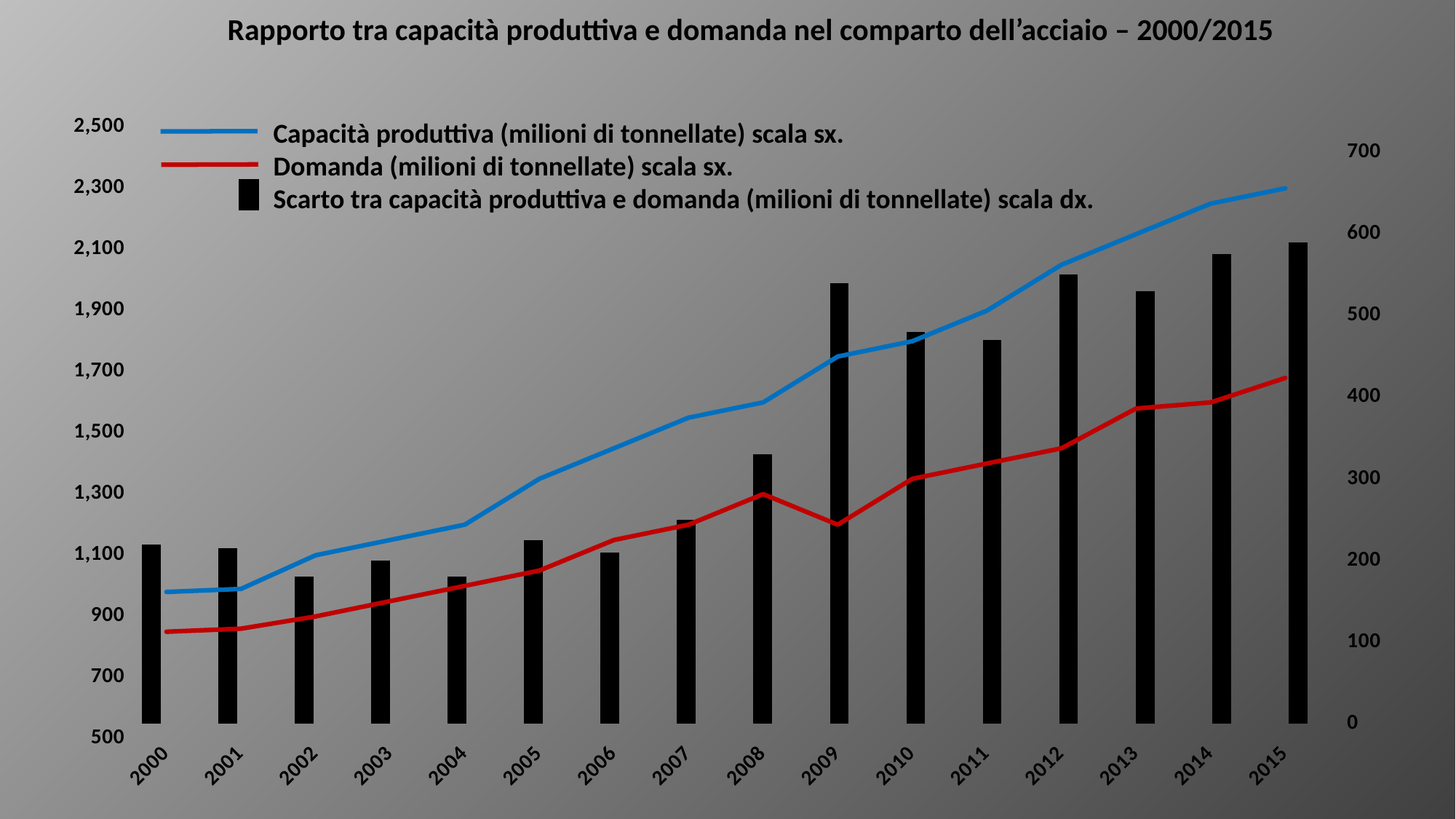
Does the 'Domanda' line rise or fall between 2008 and 2009? Falls Is the value of 'Capacità produttiva' in 2015 greater or less than 2,100? greater What kind of chart is shown on the slide? A combination of line and bar chart How many series does the legend list? 3 Is the value of 'Domanda' in 2000 greater or less than 900? less How many years are plotted along the x axis? 16 Does the 'Capacità produttiva' line rise or fall from 2000 to 2015? Rises Is the 'Scarto' bar for 2008 greater or less than 400 on the right-hand scale? less Which is larger, the 'Domanda' value in 2008 or in 2009? 2008 Which colour is used for the 'Domanda' line? Red What is the title of the chart? Rapporto tra capacità produttiva e domanda nel comparto dell'acciaio – 2000/2015